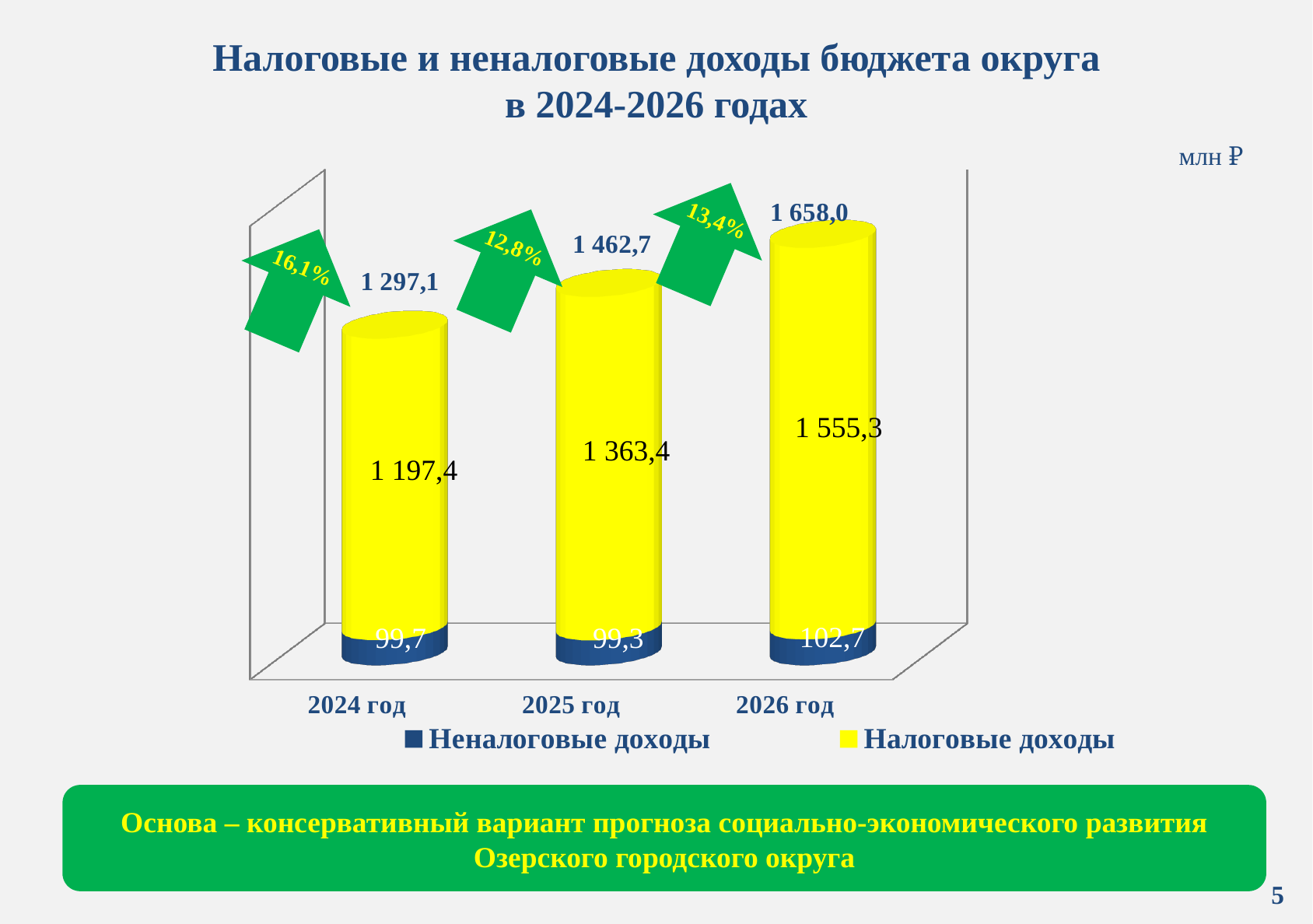
Which is larger: Налоговые доходы in 2025 год or in 2024 год? 2025 год Which year has the highest value of Налоговые доходы? 2026 год What is the value of Неналоговые доходы for 2026 год? 102,7 What kind of chart is shown on the slide? Stacked bar chart What is the difference between Налоговые доходы in 2026 год and 2025 год? 191,9 Which year has the lowest value of Неналоговые доходы? 2025 год How many series does the legend list? 2 How many years are shown on the x axis? 3 What is the value of Налоговые доходы for 2024 год? 1 197,4 What is the total of the stacked bar for 2026 год? 1 658,0 What is the total of the stacked bar for 2025 год? 1 462,7 What is the difference between the total for 2026 год and the total for 2024 год? 360,9